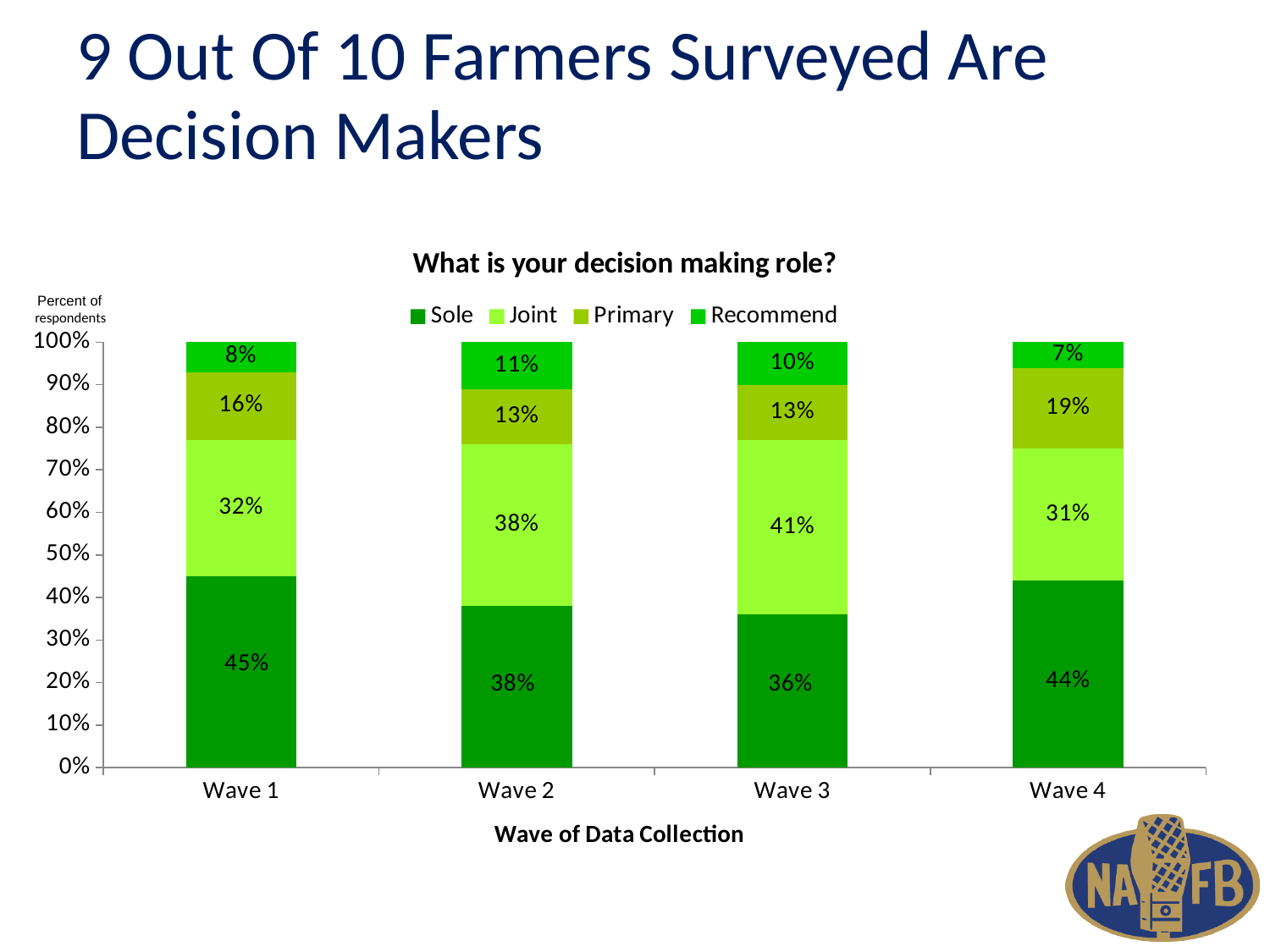
What is the title of the chart? What is your decision making role? What is the Joint value for Wave 2? 38% What percentage of respondents in Wave 1 reported a Sole decision making role? 45% Does the Recommend value rise or fall from Wave 2 to Wave 4? Fall How many percentage points higher is the Primary value in Wave 4 than in Wave 1? 3 percentage points How many series does the legend list? 4 Which wave has the lowest Sole percentage? Wave 3 What kind of chart is shown on the slide? Stacked bar chart How many waves of data collection are shown on the x axis? 4 What is the Recommend value for Wave 4? 7% Is the Sole value larger in Wave 1 or Wave 4? Wave 1 Which wave has the highest Joint percentage? Wave 3